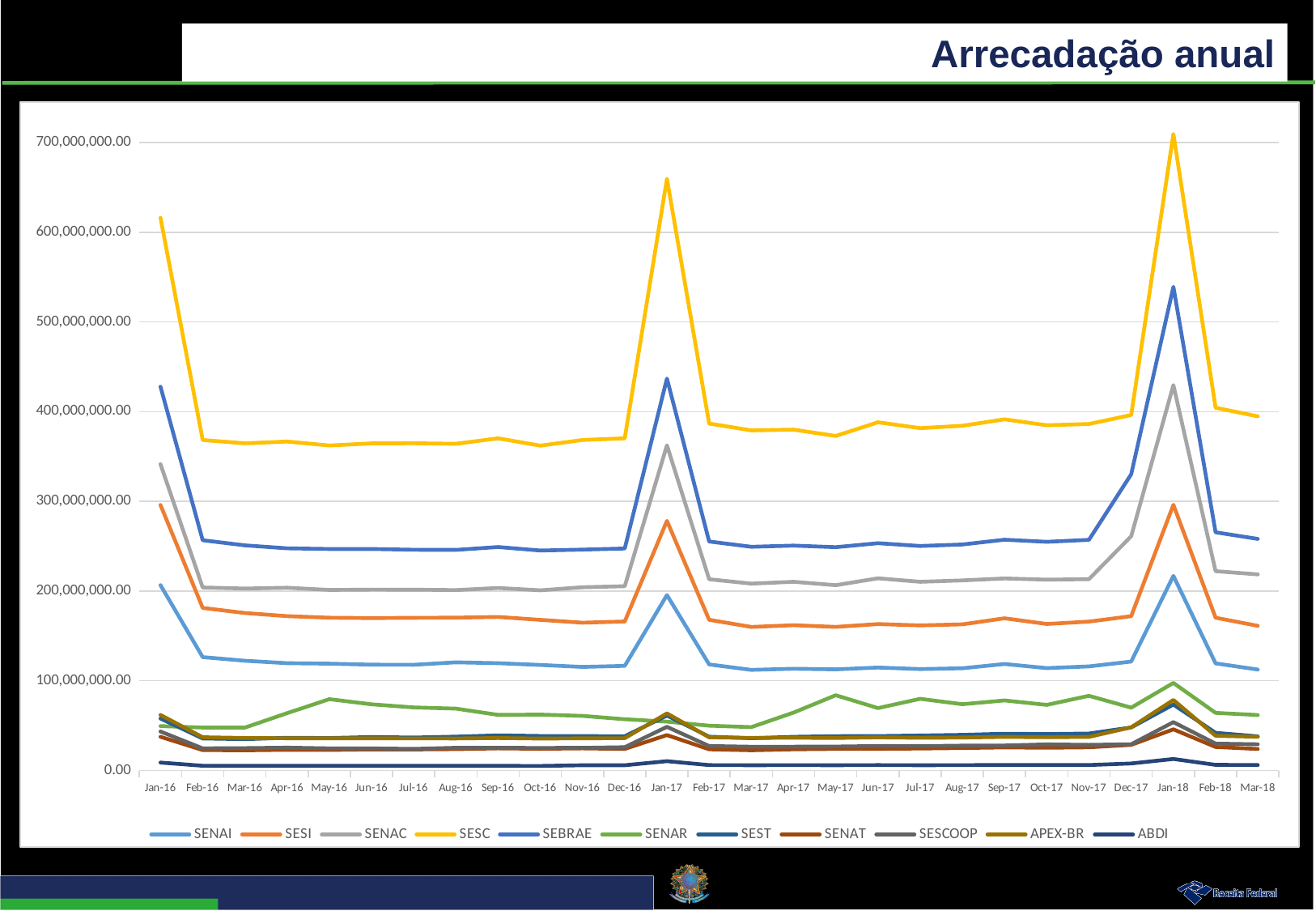
Which series has the highest values across the chart? SESC How many series does the legend list? 11 Is the value for SEBRAE in Jan-18 greater or less than 500,000,000.00? greater Is the value for SESI in Feb-16 greater or less than 200,000,000.00? less What kind of chart is shown on the slide? line chart Which series has the lowest values across the chart? ABDI What is the title of the slide containing the chart? Arrecadação anual How many monthly points are plotted along the x axis, from Jan-16 to Mar-18? 27 In Jan-17, which is larger: the value for SESC or the value for SEBRAE? SESC Is the value for SESC in Jan-17 greater or less than 600,000,000.00? greater Does the SEBRAE line rise or fall from Dec-16 to Jan-17? rise